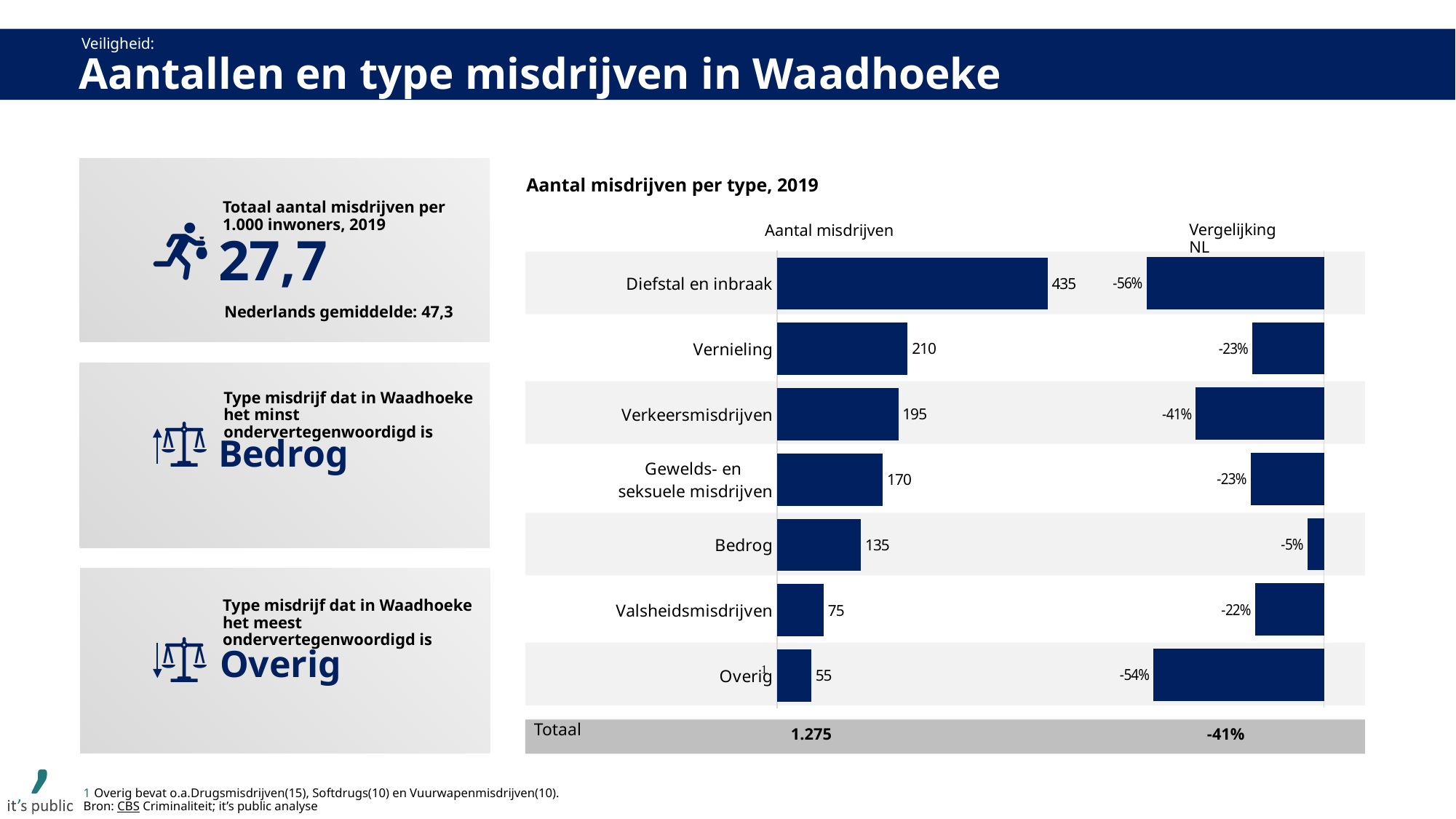
What kind of chart is 'Aantal misdrijven per type, 2019'? Bar chart In the 'Aantal misdrijven' panel, which is larger: Bedrog or Valsheidsmisdrijven? Bedrog In the 'Aantal misdrijven' panel, which category has the highest value? Diefstal en inbraak In the 'Aantal misdrijven' panel of the chart 'Aantal misdrijven per type, 2019', what is the value for Diefstal en inbraak? 435 In the 'Aantal misdrijven' panel, which category has the lowest value? Overig How many crime-type categories are plotted in the chart 'Aantal misdrijven per type, 2019' (excluding the Totaal row)? 7 In the 'Aantal misdrijven' panel, what is the value for Gewelds- en seksuele misdrijven? 170 What is the Totaal value shown for the 'Vergelijking NL' panel? -41% In the 'Aantal misdrijven' panel, what is the difference between Vernieling and Verkeersmisdrijven? 15 What is the Totaal value shown for the 'Aantal misdrijven' panel? 1.275 In the 'Vergelijking NL' panel, what is the value for Verkeersmisdrijven? -41% In the 'Vergelijking NL' panel, what is the value for Bedrog? -5%